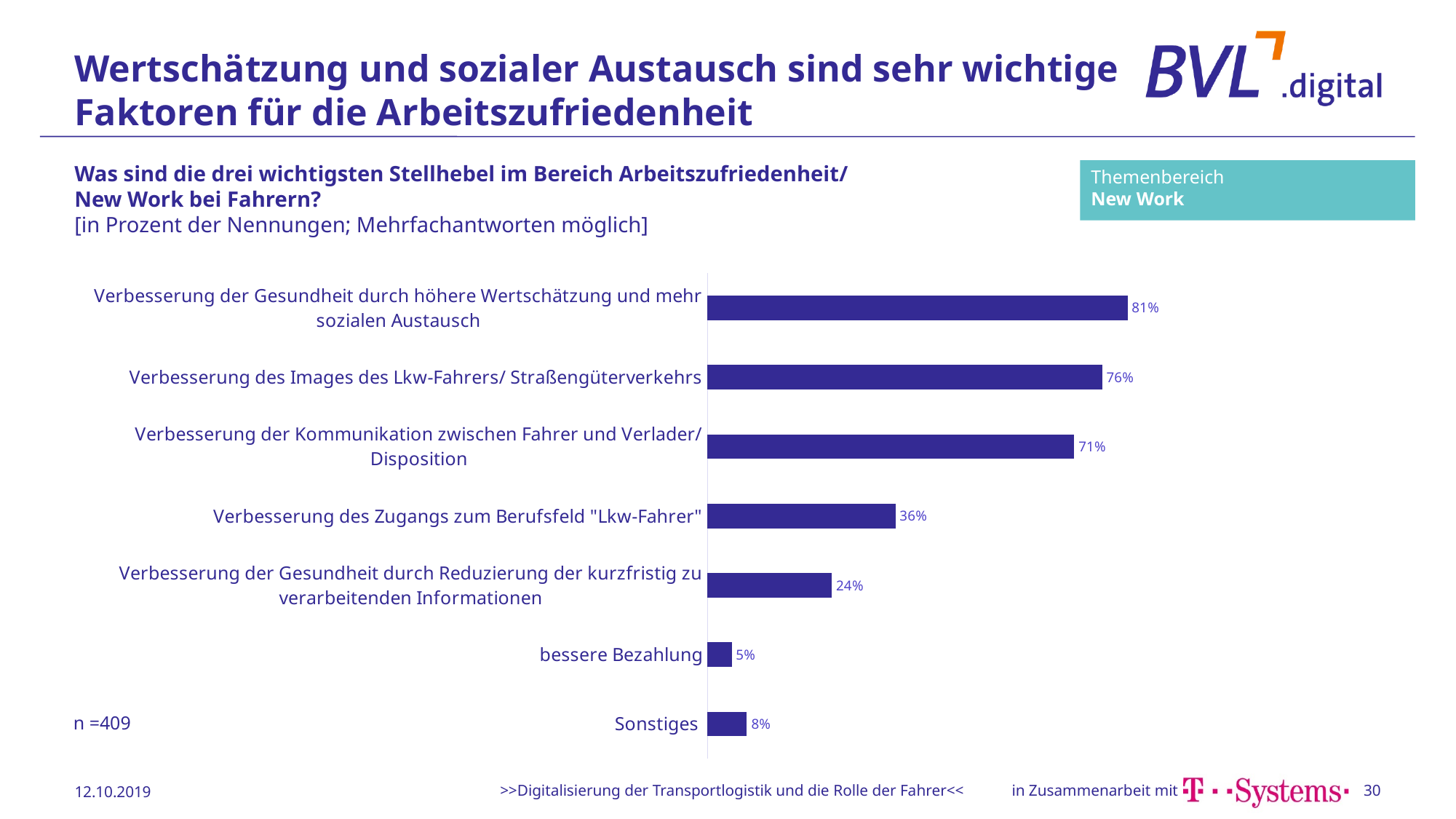
What is the value for "Verbesserung des Zugangs zum Berufsfeld "Lkw-Fahrer""? 36% What is the value for "Sonstiges"? 8% What is the sample size (n) stated on the slide? 409 How many categories are shown in the chart? 7 Which category has the lowest value? bessere Bezahlung What is the difference between the values for "Verbesserung der Gesundheit durch höhere Wertschätzung und mehr sozialen Austausch" and "Verbesserung der Kommunikation zwischen Fahrer und Verlader/ Disposition"? 10% What kind of chart is shown on the slide? Bar chart Which is larger: the value for "Sonstiges" or the value for "bessere Bezahlung"? Sonstiges What is the value for "Verbesserung des Images des Lkw-Fahrers/ Straßengüterverkehrs"? 76% What is the value for "bessere Bezahlung"? 5% What is the difference between the values for "Verbesserung des Zugangs zum Berufsfeld "Lkw-Fahrer"" and "Verbesserung der Gesundheit durch Reduzierung der kurzfristig zu verarbeitenden Informationen"? 12% Which category has the highest value? Verbesserung der Gesundheit durch höhere Wertschätzung und mehr sozialen Austausch